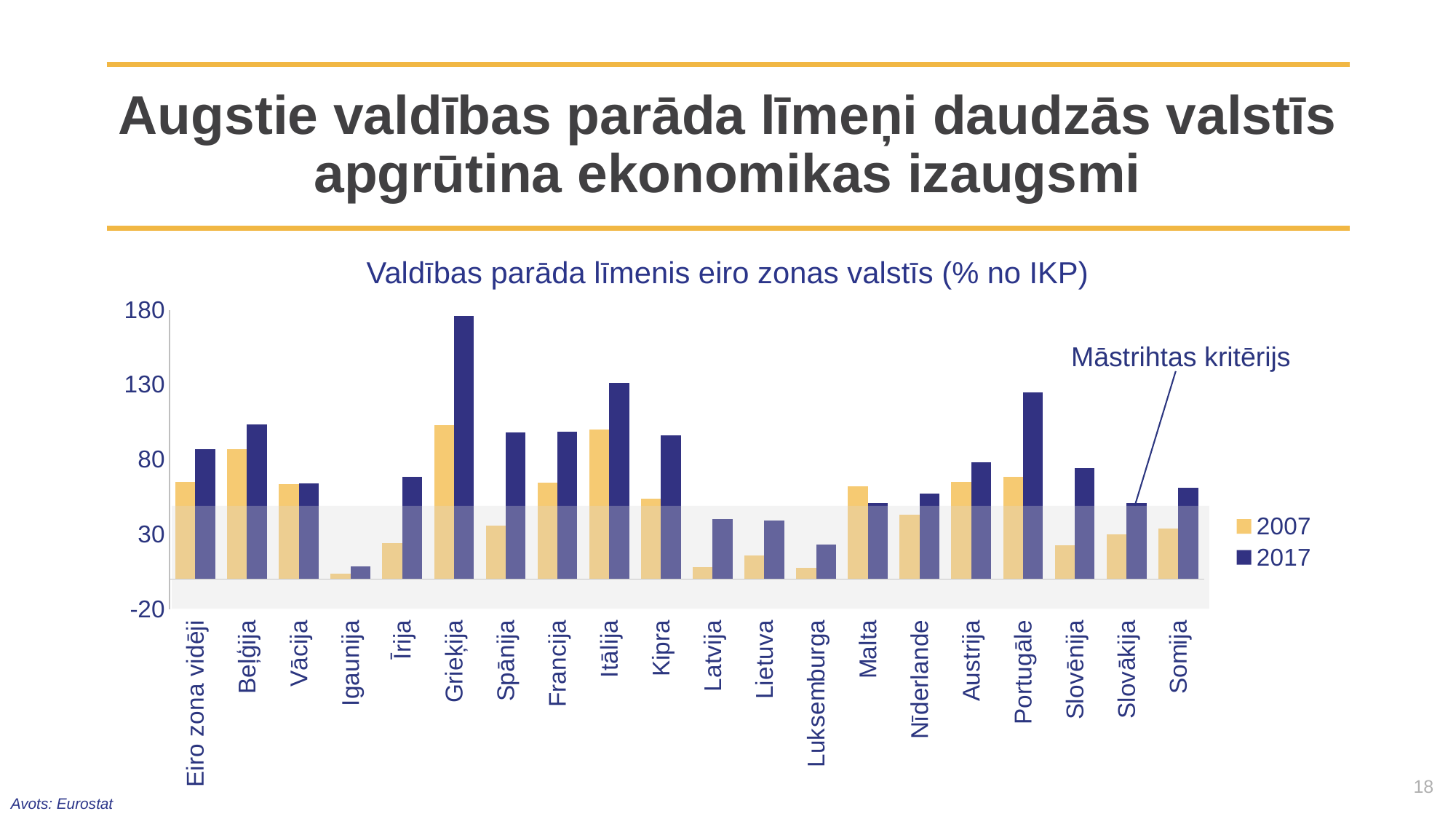
Which country has the highest government debt level in 2017? Grieķija How many series does the legend list? 2 Is the 2007 value for Igaunija greater or less than 30? less Is the 2017 value for Beļģija greater or less than 80? greater Is the 2017 value for Grieķija greater or less than 130? greater Which is larger: the 2017 value for Vācija or the 2017 value for Beļģija? Beļģija What kind of chart is shown on the slide? bar chart Which is larger: the 2017 value for Grieķija or the 2017 value for Itālija? Grieķija How many countries/categories are shown on the x axis? 20 Which country has the lowest government debt level in 2017? Igaunija What is the title of the chart? Valdības parāda līmenis eiro zonas valstīs (% no IKP)